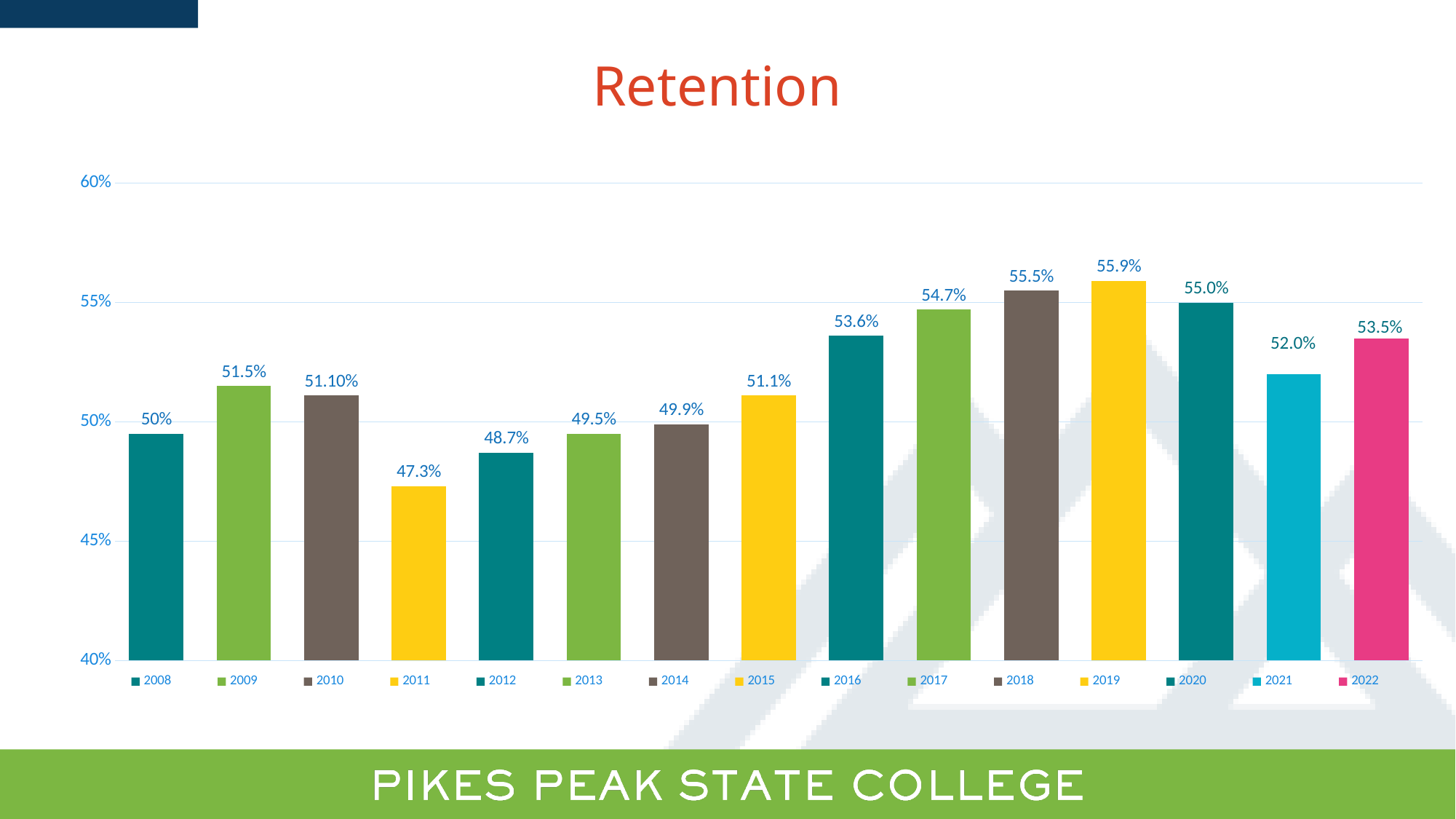
What is the retention value for 2019? 55.9% What is the difference in retention between 2019 and 2011? 8.6 percentage points What is the retention value for 2011? 47.3% What is the retention value for 2010? 51.10% Which year has higher retention, 2016 or 2020? 2020 Which year has the lowest retention? 2011 How many years are shown in the chart? 15 What is the difference in retention between 2022 and 2021? 1.5 percentage points Which year has the highest retention? 2019 What kind of chart is shown on the slide? Bar chart What is the retention value for 2022? 53.5% Does retention rise or fall from 2011 to 2019? Rise